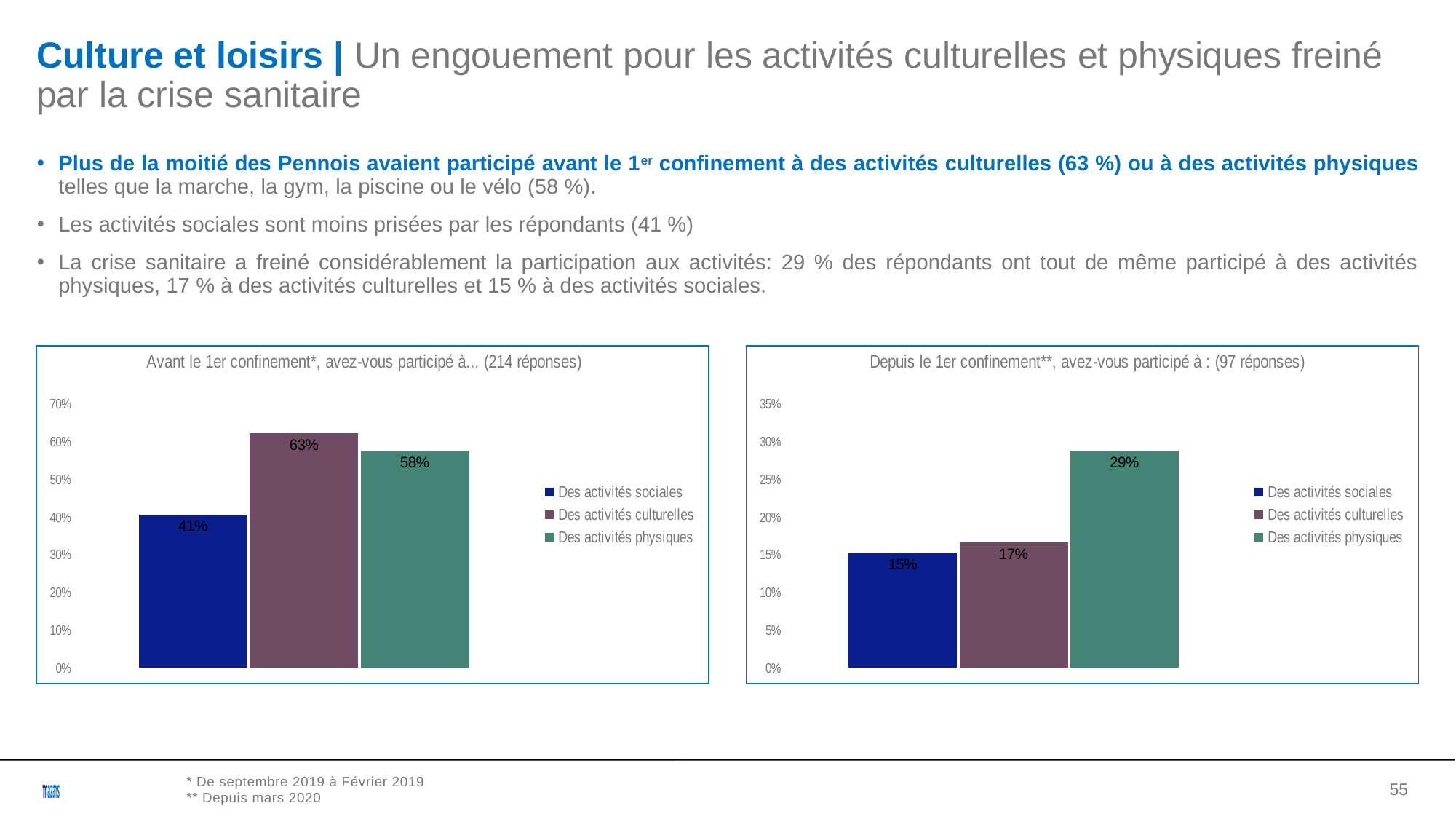
In the right chart (Depuis le 1er confinement), what is the value for Des activités sociales? 15% In the left chart (Avant le 1er confinement), which series has the highest value? Des activités culturelles In the left chart (Avant le 1er confinement), what is the value for Des activités culturelles? 63% How many series does the legend of the right chart (Depuis le 1er confinement) list? 3 What kind of chart is the left chart (Avant le 1er confinement)? Bar chart In the right chart (Depuis le 1er confinement), which series has the lowest value? Des activités sociales In the left chart (Avant le 1er confinement), what is the value for Des activités sociales? 41% In the left chart (Avant le 1er confinement), which is larger: Des activités sociales or Des activités physiques? Des activités physiques How many responses does the title of the right chart (Depuis le 1er confinement) mention? 97 réponses In the left chart (Avant le 1er confinement), what is the difference between Des activités culturelles and Des activités physiques? 5% In the right chart (Depuis le 1er confinement), what is the value for Des activités physiques? 29% In the right chart (Depuis le 1er confinement), what is the difference between Des activités physiques and Des activités culturelles? 12%